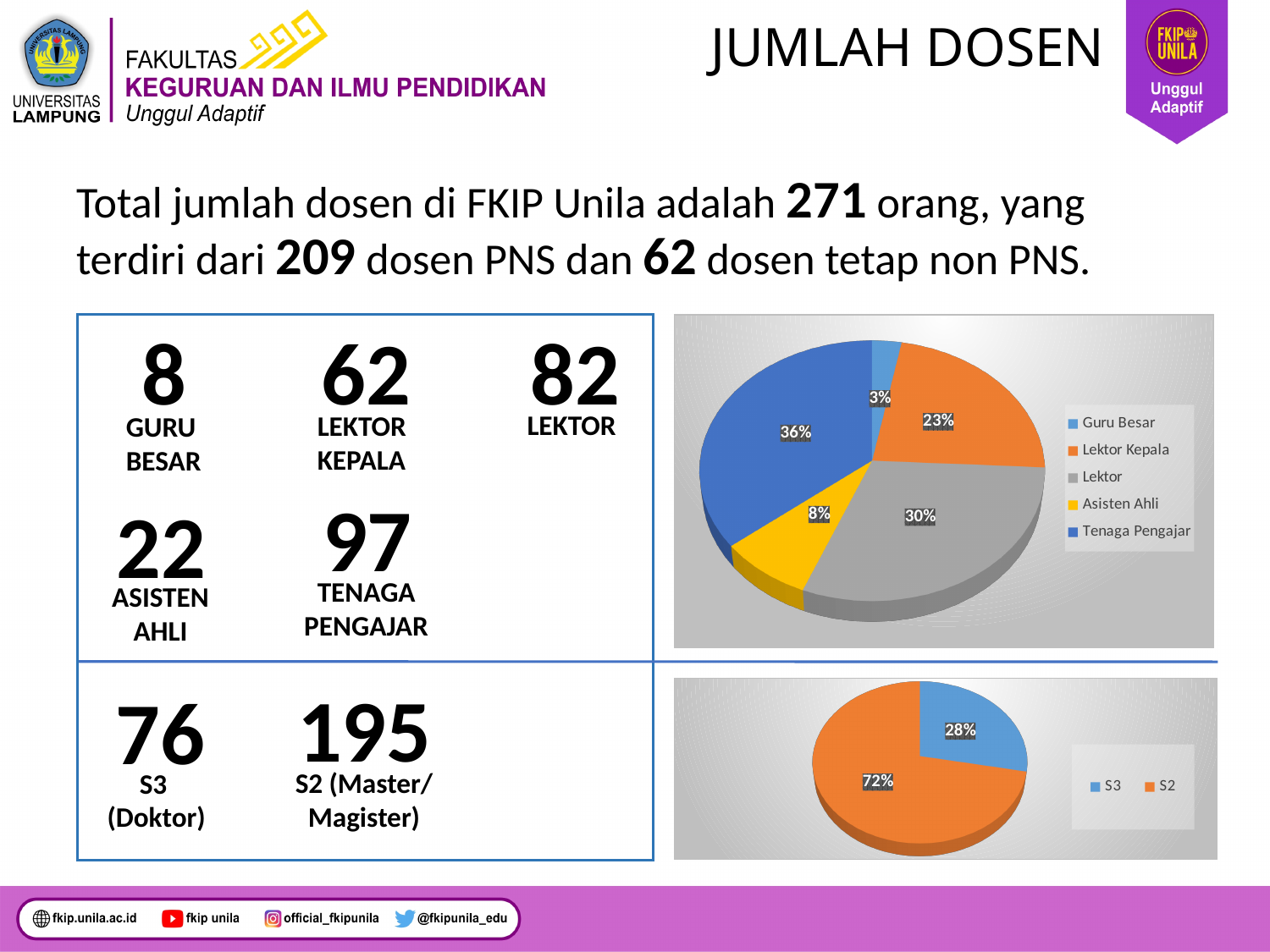
In the top pie chart, what is the difference in percentage points between Tenaga Pengajar and Lektor? 6 In the top pie chart, what colour is the Asisten Ahli slice? Yellow In the top pie chart, what share does Lektor Kepala have? 23% In the bottom pie chart, what share does S3 have? 28% In the top pie chart, what share does Asisten Ahli have? 8% In the top pie chart, which category has the largest slice? Tenaga Pengajar In the top pie chart, how many categories does the legend list? 5 In the bottom pie chart, which category has the larger slice? S2 What type of chart is the bottom chart? Pie chart In the top pie chart, which is larger, Lektor or Lektor Kepala? Lektor In the top pie chart, which category has the smallest slice? Guru Besar